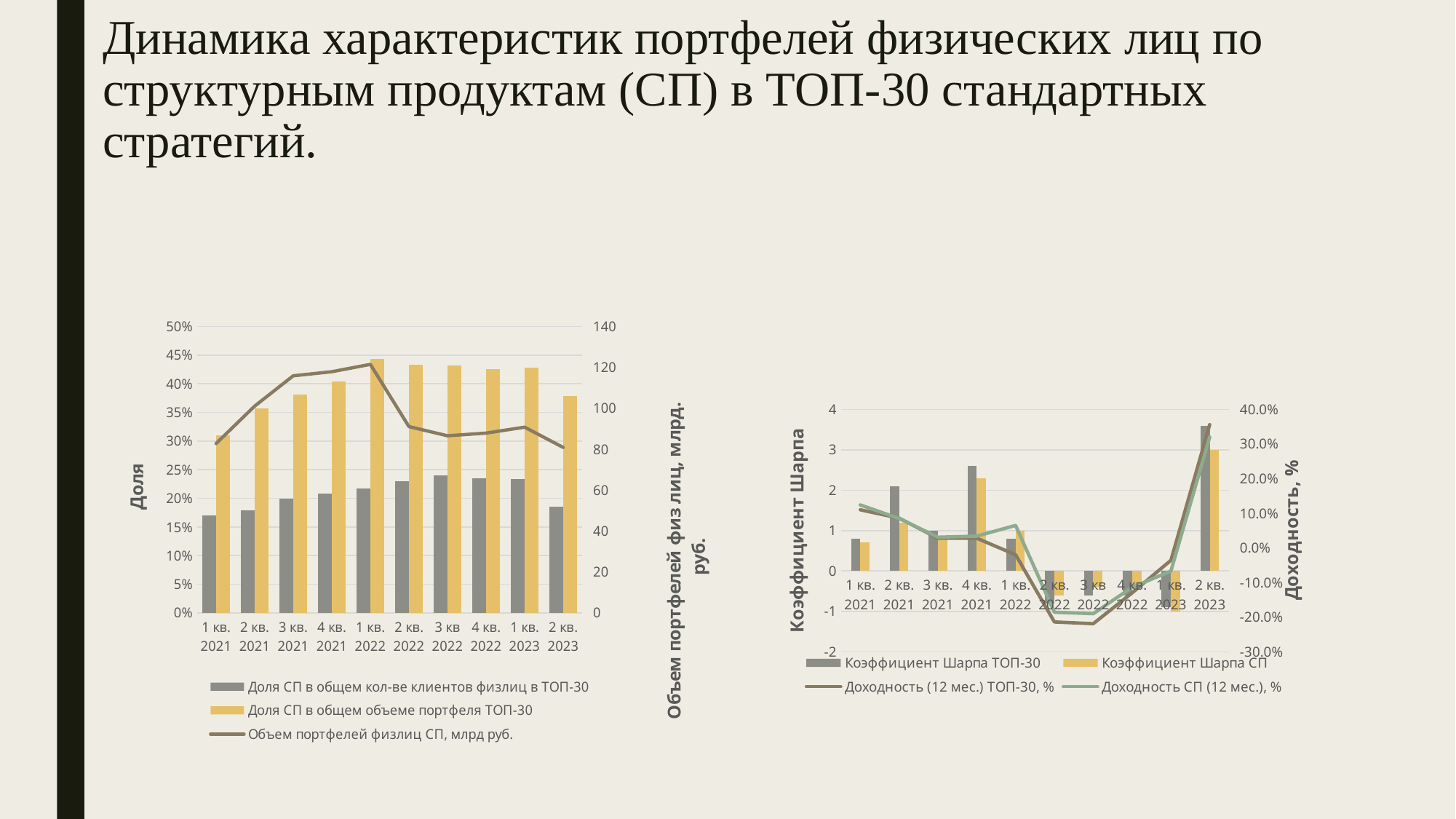
On the right chart, in which quarter is 'Коэффициент Шарпа ТОП-30' highest? 2 кв. 2023 What kind of chart is the right chart? Combined bar and line chart On the left chart, how many quarters are shown on the x axis? 10 On the left chart, is the value of 'Объем портфелей физлиц СП, млрд руб.' for 2 кв. 2023 greater or less than 100? less On the left chart, how many series does the legend list? 3 On the left chart, is the value of 'Доля СП в общем кол-ве клиентов физлиц в ТОП-30' for 1 кв. 2021 greater or less than 20%? less On the left chart, in which quarter is the series 'Доля СП в общем объеме портфеля ТОП-30' lowest? 1 кв. 2021 On the left chart, in which quarter does the line 'Объем портфелей физлиц СП, млрд руб.' reach its peak? 1 кв. 2022 On the right chart, is the value of 'Коэффициент Шарпа ТОП-30' for 2 кв. 2023 greater or less than 3? greater On the right chart, how many series does the legend list? 4 On the left chart, in which quarter is the series 'Доля СП в общем объеме портфеля ТОП-30' highest? 1 кв. 2022 On the right chart, for 4 кв. 2021, which is larger: 'Коэффициент Шарпа ТОП-30' or 'Коэффициент Шарпа СП'? Коэффициент Шарпа ТОП-30